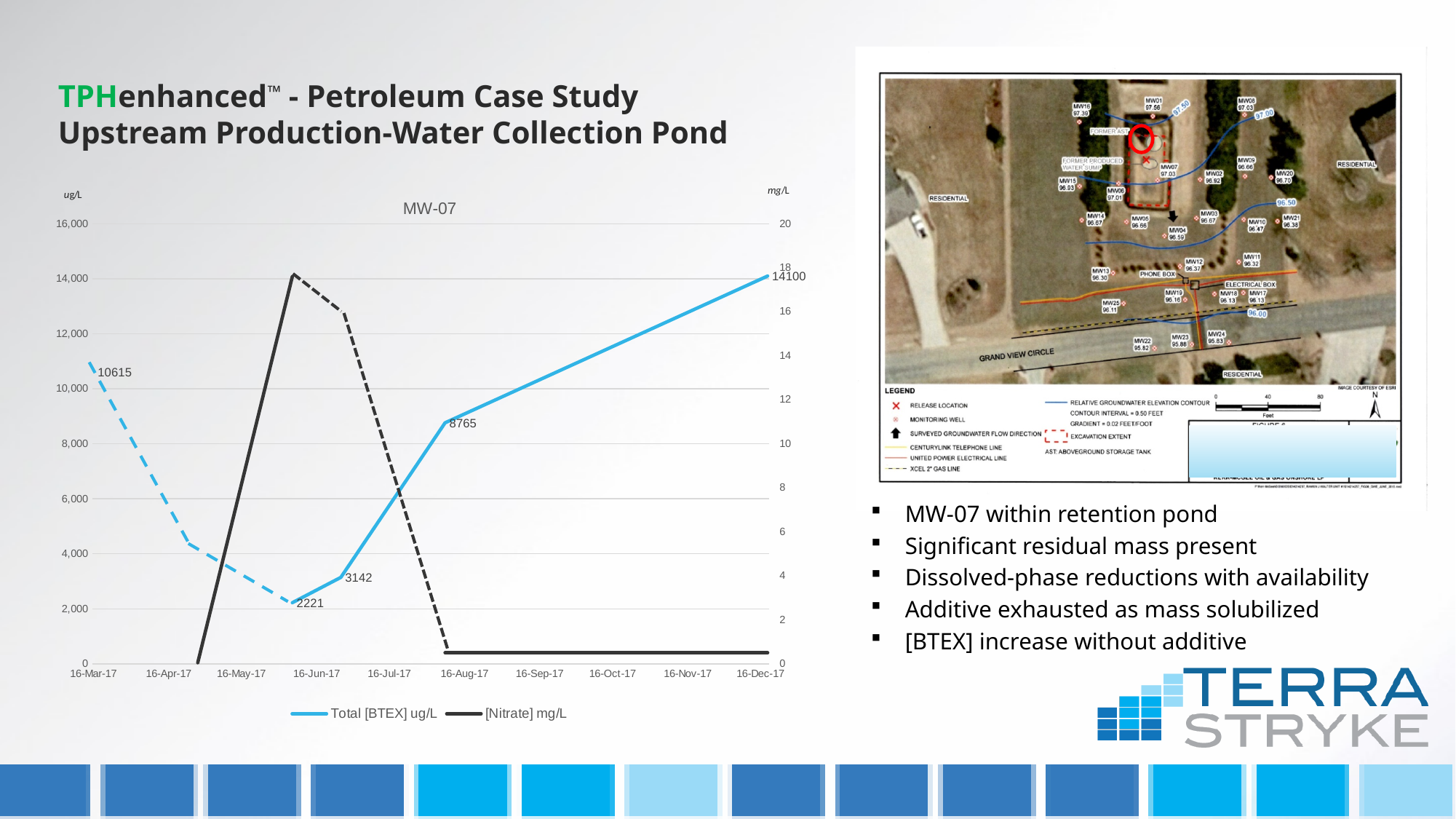
What is the Total [BTEX] ug/L value on 16-Dec-17? 14100 What is the title of the chart? MW-07 What is the Total [BTEX] ug/L value on 16-Mar-17? 10615 What is the Total [BTEX] ug/L value on 16-Aug-17? 8765 What is the difference between the Total [BTEX] ug/L values on 16-Dec-17 and 16-Aug-17? 5335 What kind of chart is shown on the slide? line chart How many series does the chart legend list? 2 Does the Total [BTEX] ug/L series rise or fall from 16-May-17 to 16-Dec-17? rise